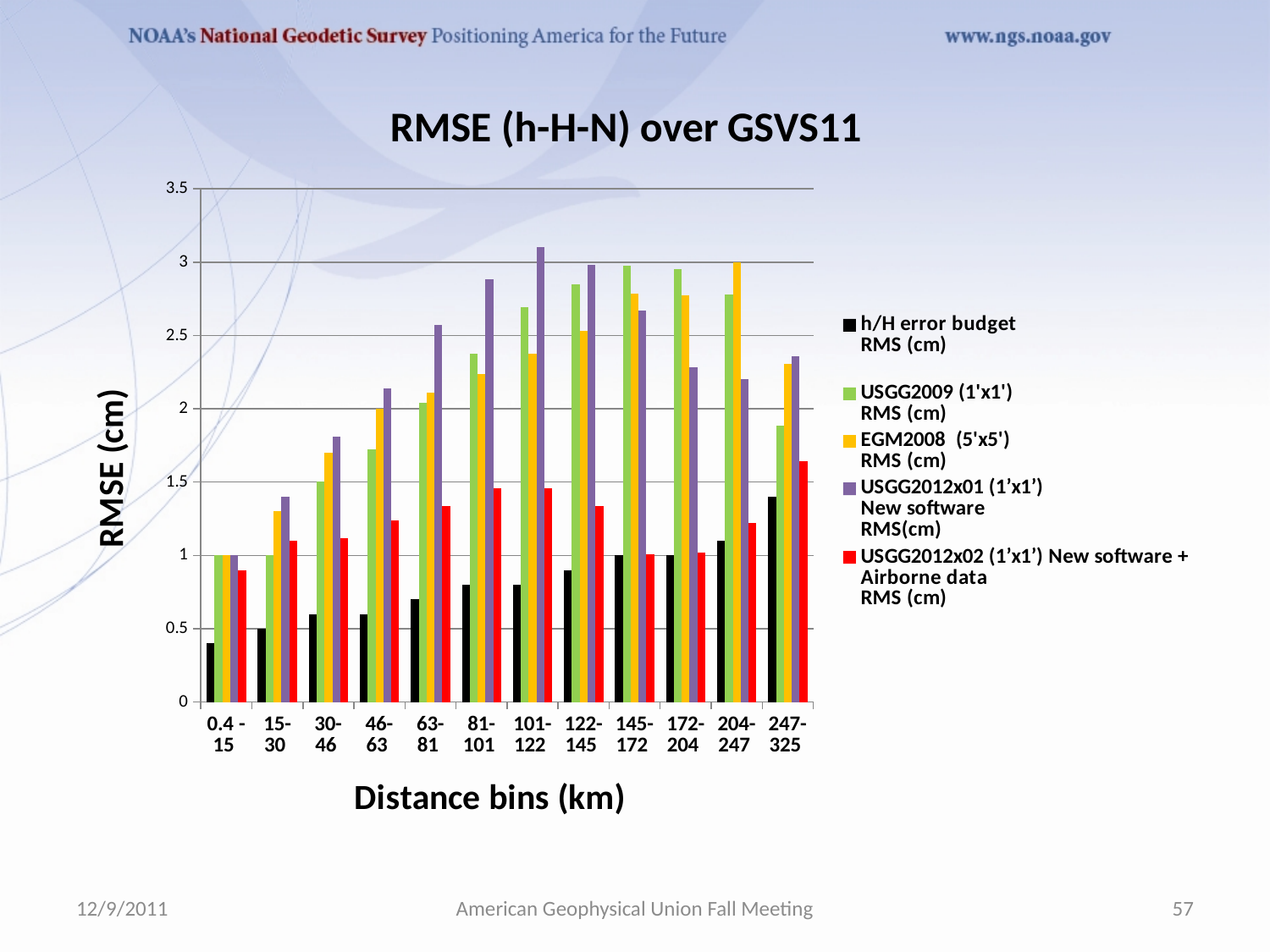
Is the value for USGG2012x01 (1'x1') New software in the 101-122 km bin greater or less than 3? greater How many series does the legend list? 5 Is the value for USGG2012x02 (1'x1') New software + Airborne data in the 247-325 km bin greater or less than 1.5? greater Is the value for h/H error budget RMS in the 0.4-15 km bin greater or less than 0.5? less What kind of chart is shown on the slide? bar chart Which series has the highest bar in the 101-122 km distance bin? USGG2012x01 (1'x1') New software RMS(cm) In the 247-325 km bin, which is larger: the USGG2009 (1'x1') bar or the EGM2008 (5'x5') bar? EGM2008 (5'x5') RMS (cm) Do the h/H error budget RMS values generally rise or fall as the distance bins increase along the x axis? rise In which distance bin is the USGG2012x01 (1'x1') New software bar the highest? 101-122 Which series has the lowest bar in the 30-46 km distance bin? h/H error budget RMS (cm) How many distance bins are shown on the x axis? 12 What is the title of the chart? RMSE (h-H-N) over GSVS11